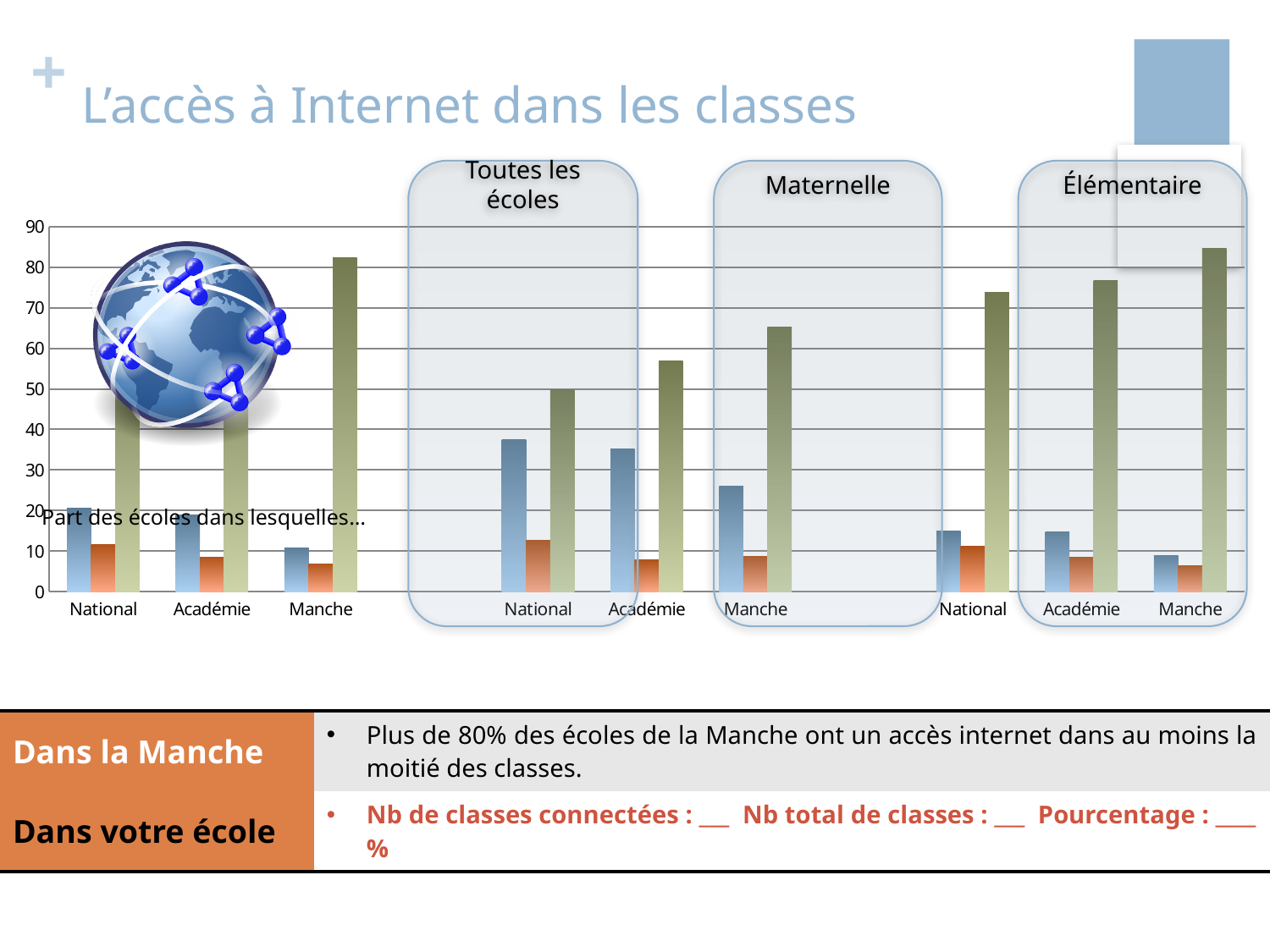
What are the three group headings shown above the chart? Toutes les écoles, Maternelle, Élémentaire In the Élémentaire group, do the green bars rise or fall from National to Manche? rise In the Maternelle group, is the green bar for Manche greater or less than 60? greater In the Élémentaire group, is the green bar for Manche greater or less than 80? greater In the Élémentaire group, is the orange bar for Manche greater or less than 10? less What is the highest tick value shown on the y axis? 90 What kind of chart is shown on the slide? bar chart In the Maternelle group, which green bar is taller: Manche or Académie? Manche How many category labels appear along the x axis of the chart? 9 In the Élémentaire group, which category has the tallest green bar? Manche How many bars are plotted for each category on the x axis? 3